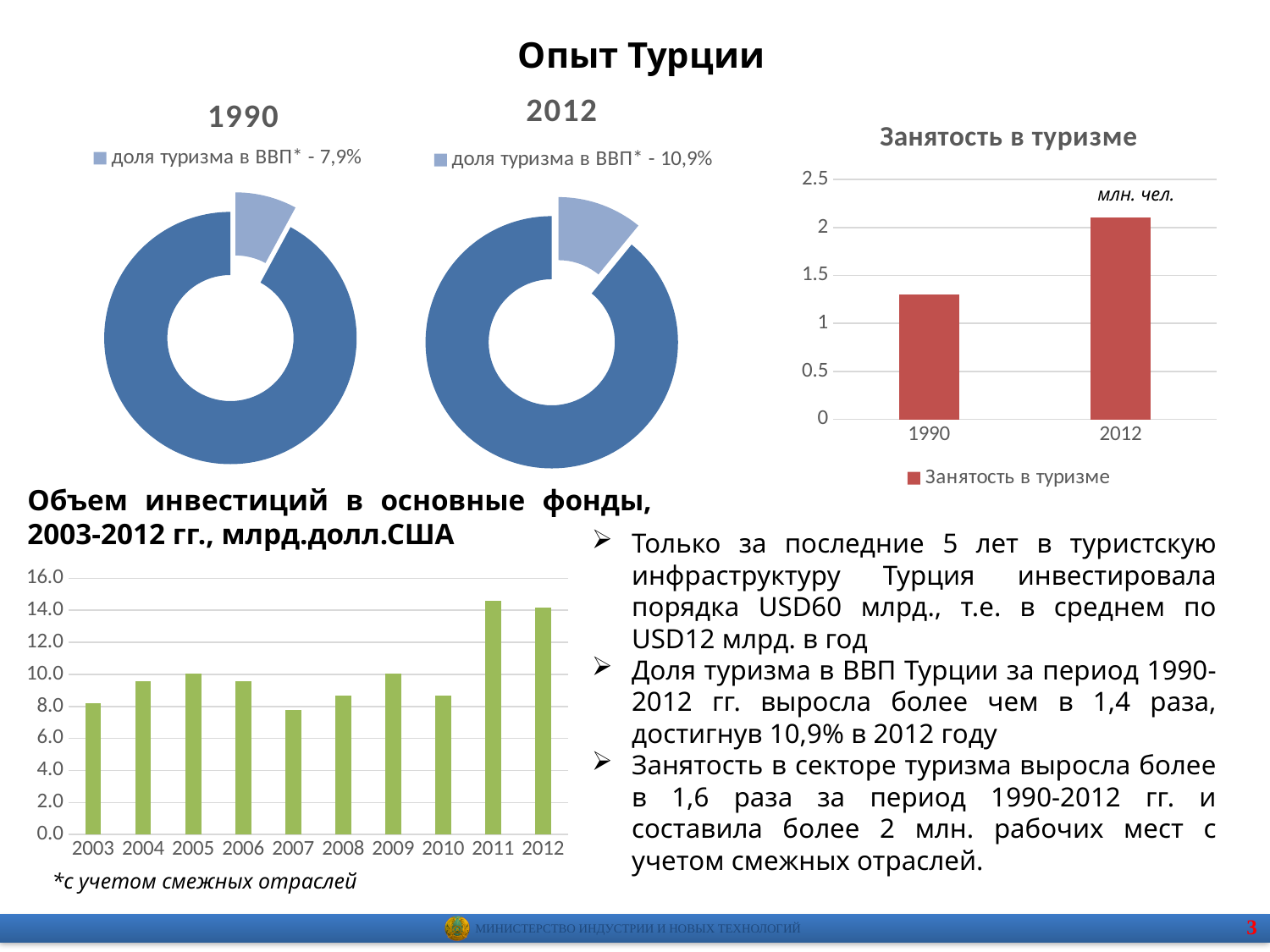
In the 1990 doughnut chart, what share of GDP does tourism account for according to the legend? 7,9% In the 2012 doughnut chart, what share of GDP does tourism account for according to the legend? 10,9% In the 'Занятость в туризме' chart, is the value for 1990 greater or less than 1.5? less In the 'Объем инвестиций в основные фонды' chart, which year has the lowest value? 2007 How many categories are shown on the x axis of the 'Занятость в туризме' chart? 2 In the 'Занятость в туризме' chart, which year has the higher value? 2012 What kind of chart is 'Занятость в туризме'? bar chart How many years are shown on the x axis of the 'Объем инвестиций в основные фонды' chart? 10 Comparing the 1990 and 2012 doughnut charts, which year shows the larger share of tourism in GDP? 2012 What kind of chart is the 1990 chart on the left of the slide? doughnut chart How many series does the legend of the 'Занятость в туризме' chart list? 1 In the 'Объем инвестиций в основные фонды' chart, is the value for 2011 greater or less than 12.0? greater